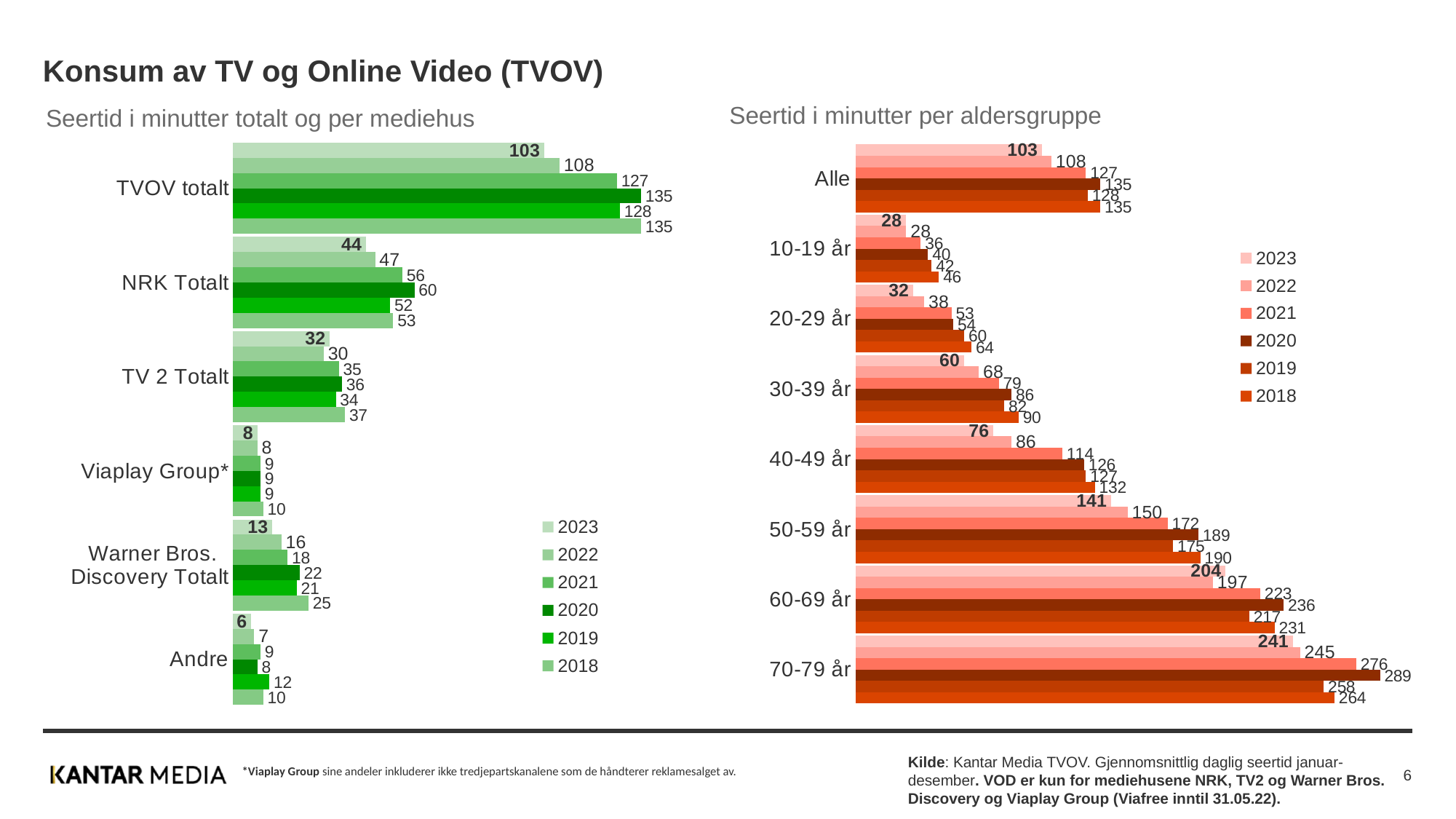
In the chart 'Seertid i minutter totalt og per mediehus', what is the 2020 value for TVOV totalt? 135 In the chart 'Seertid i minutter totalt og per mediehus', how many series does the legend list? 6 What kind of chart is 'Seertid i minutter per aldersgruppe'? Bar chart In the chart 'Seertid i minutter per aldersgruppe', which is larger: the 2021 value for 50-59 år or the 2021 value for 40-49 år? 50-59 år In the chart 'Seertid i minutter totalt og per mediehus', how many categories are shown? 6 In the chart 'Seertid i minutter per aldersgruppe', what is the difference between the 2018 and 2023 values for 30-39 år? 30 In the chart 'Seertid i minutter per aldersgruppe', how many age-group categories are shown? 8 In the chart 'Seertid i minutter totalt og per mediehus', what is the difference between the 2018 and 2023 values for TVOV totalt? 32 In the chart 'Seertid i minutter per aldersgruppe', which age group has the highest 2020 value? 70-79 år In the chart 'Seertid i minutter per aldersgruppe', what is the 2023 value for 60-69 år? 204 In the chart 'Seertid i minutter totalt og per mediehus', what is the 2023 value for NRK Totalt? 44 In the chart 'Seertid i minutter totalt og per mediehus', which category has the lowest 2023 value? Andre